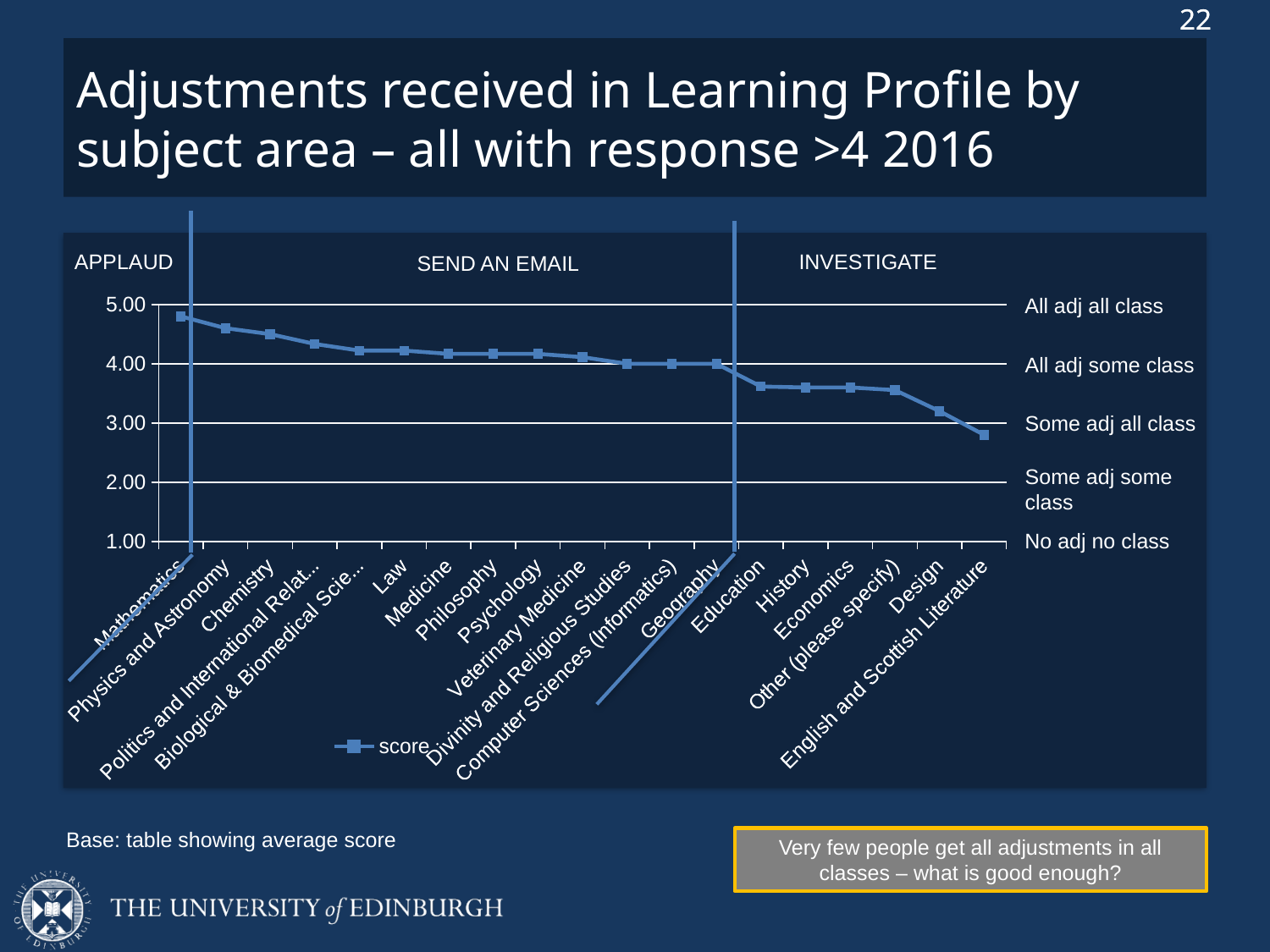
Which subject area has the lowest score? English and Scottish Literature What is the name of the series shown in the legend? score Which subject area has the highest score? Mathematics How many subject areas are plotted along the x axis? 19 What kind of chart is shown on the slide? line chart What are the three zone labels written across the top of the chart area? APPLAUD, SEND AN EMAIL, INVESTIGATE Is the score for Mathematics greater or less than 4.00? greater How many series does the legend list? 1 Is the score for Education greater or less than 4.00? less Is the score for English and Scottish Literature greater or less than 3.00? less Do the scores rise or fall moving from left to right along the x axis? fall Which has the higher score, Chemistry or Design? Chemistry